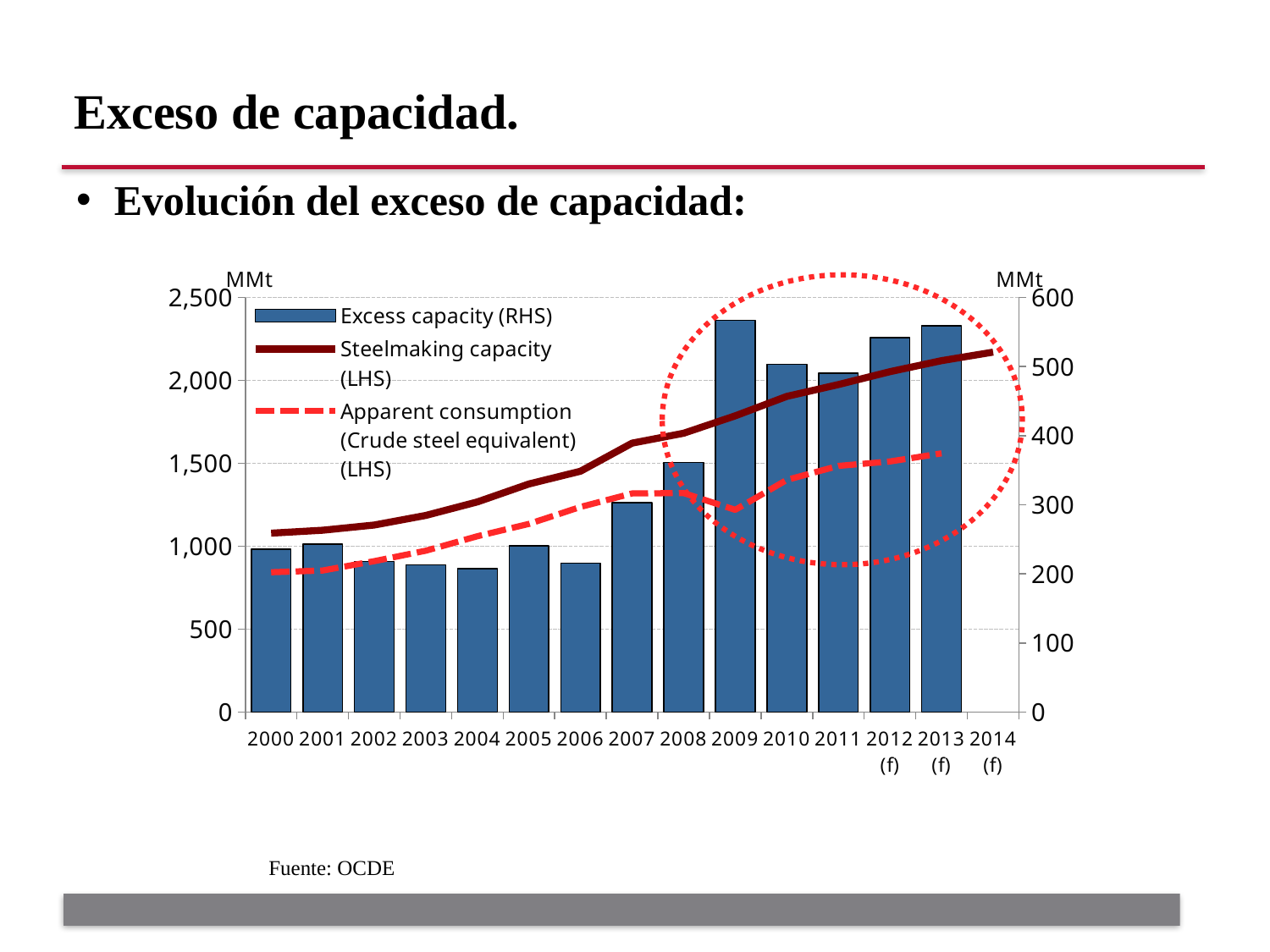
Is the Excess capacity value for 2000 greater or less than 300 on the right-hand axis? less Which year has the larger Excess capacity bar, 2009 or 2010? 2009 How many years are labelled on the x axis of the chart? 15 On which axis is the Excess capacity series plotted according to the legend? RHS (right-hand side) Is the Excess capacity value for 2008 greater or less than 300 on the right-hand axis? greater Does the Steelmaking capacity line rise or fall from 2000 to 2014? rises Which year has the highest Excess capacity bar? 2009 Is the Excess capacity value for 2009 greater or less than 500 on the right-hand axis? greater How many series does the chart legend list? 3 What kind of chart is shown on the slide? A bar chart combined with line series